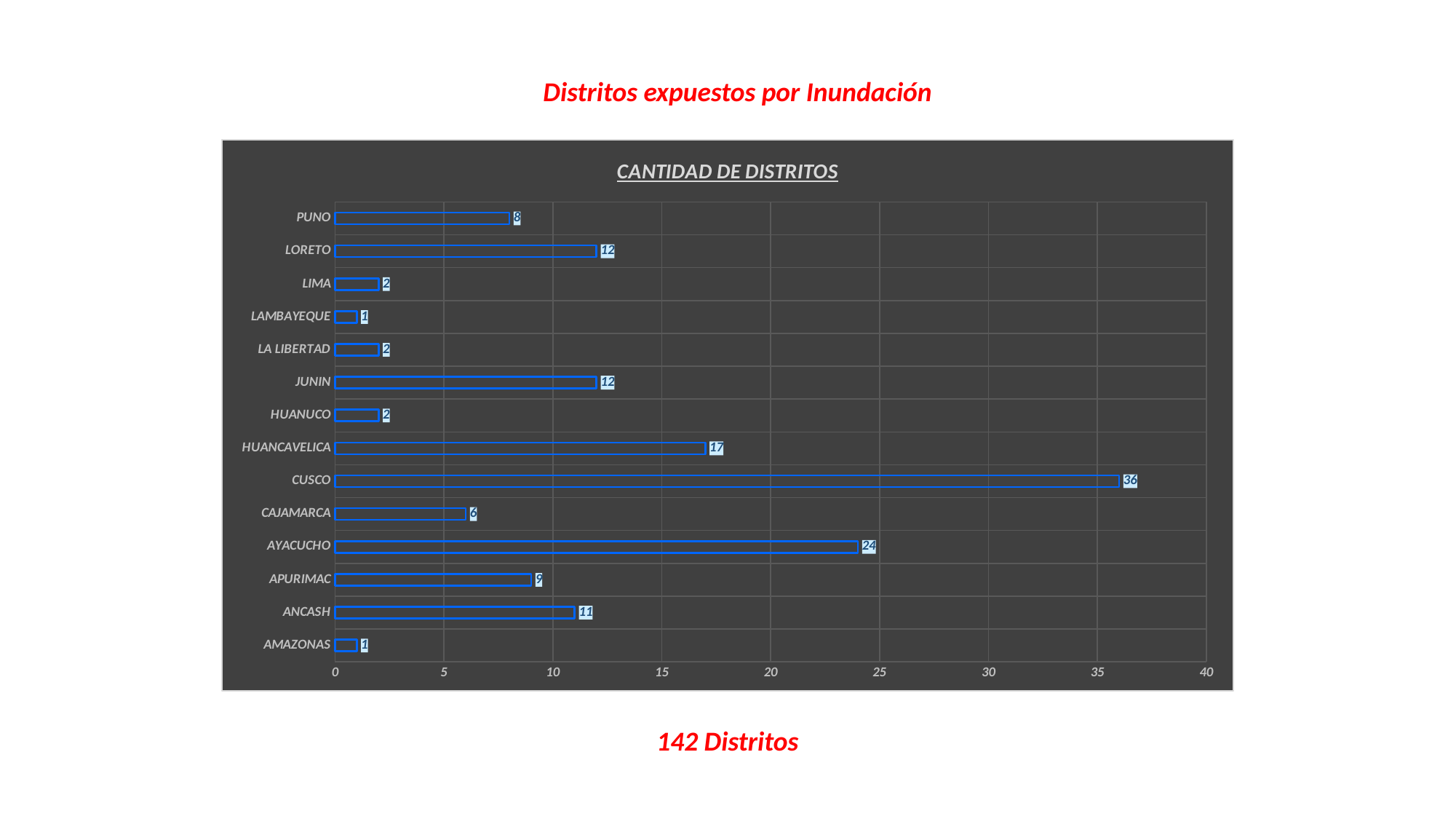
Which category has the highest value? CUSCO What is the value for AYACUCHO? 24 What is the value for HUANCAVELICA? 17 Which is larger, the value for ANCASH or the value for CAJAMARCA? ANCASH What is the title of the chart? CANTIDAD DE DISTRITOS What is the value for APURIMAC? 9 How many categories are shown in the chart? 14 What kind of chart is shown on the slide? Bar chart What is the difference between the values for LORETO and PUNO? 4 Is the value for HUANCAVELICA greater or less than 15? greater What is the value for CUSCO? 36 What is the difference between the values for CUSCO and AYACUCHO? 12